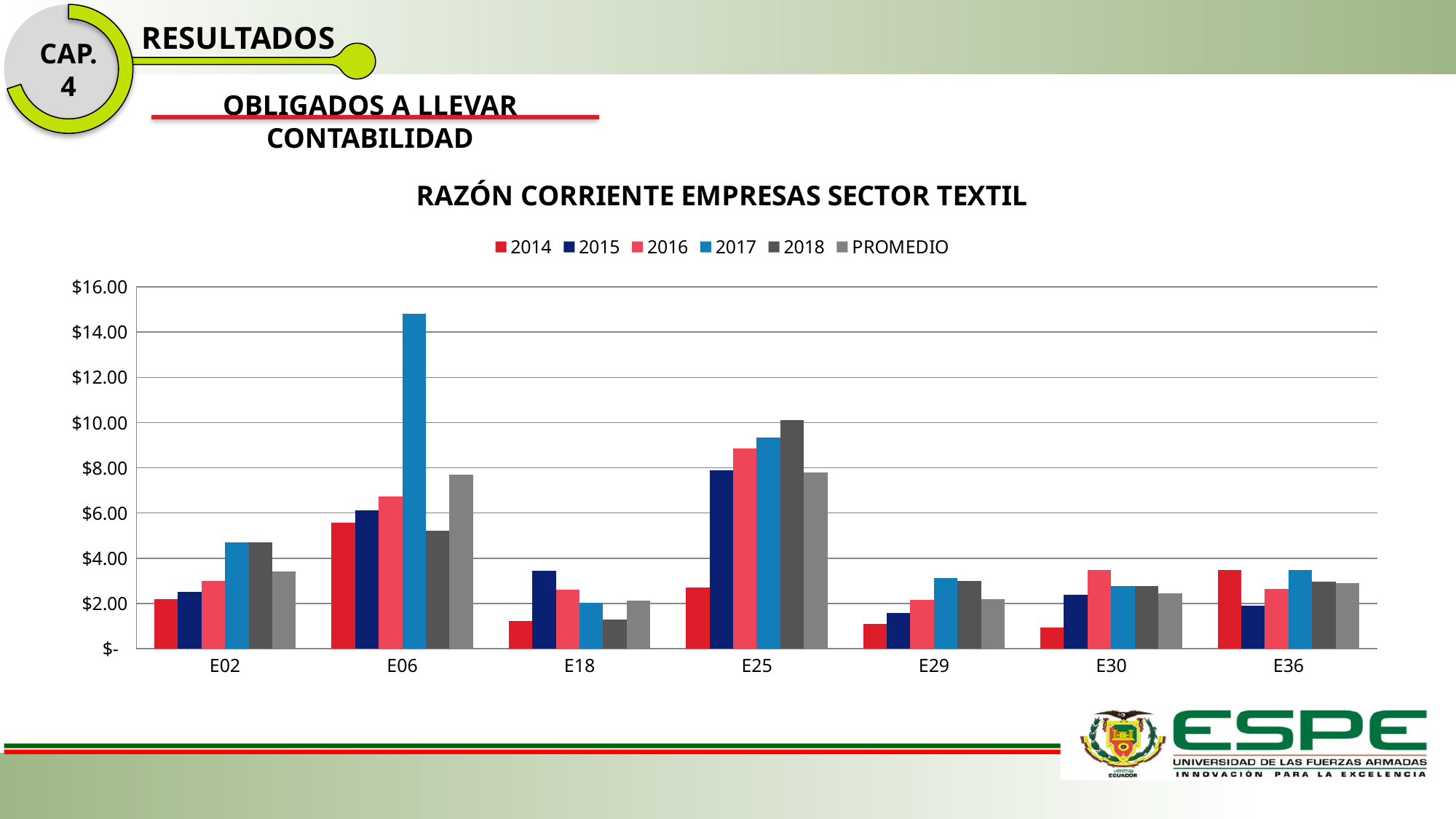
Is the PROMEDIO value for E06 greater or less than $6.00? greater Is the 2017 value for E06 greater or less than $14.00? greater What is the title of the chart? RAZÓN CORRIENTE EMPRESAS SECTOR TEXTIL For E29, which year has the lowest value? 2014 What kind of chart is shown on the slide? bar chart How many companies (categories) are shown on the x axis? 7 Which company has the highest value for 2017? E06 For E25, do the values rise or fall from 2014 to 2018? rise Is the 2018 value for E25 greater or less than $8.00? greater For E36, which is larger, the 2014 value or the 2015 value? 2014 Which is larger, the 2015 value for E25 or the 2015 value for E02? E25 How many series does the legend list? 6